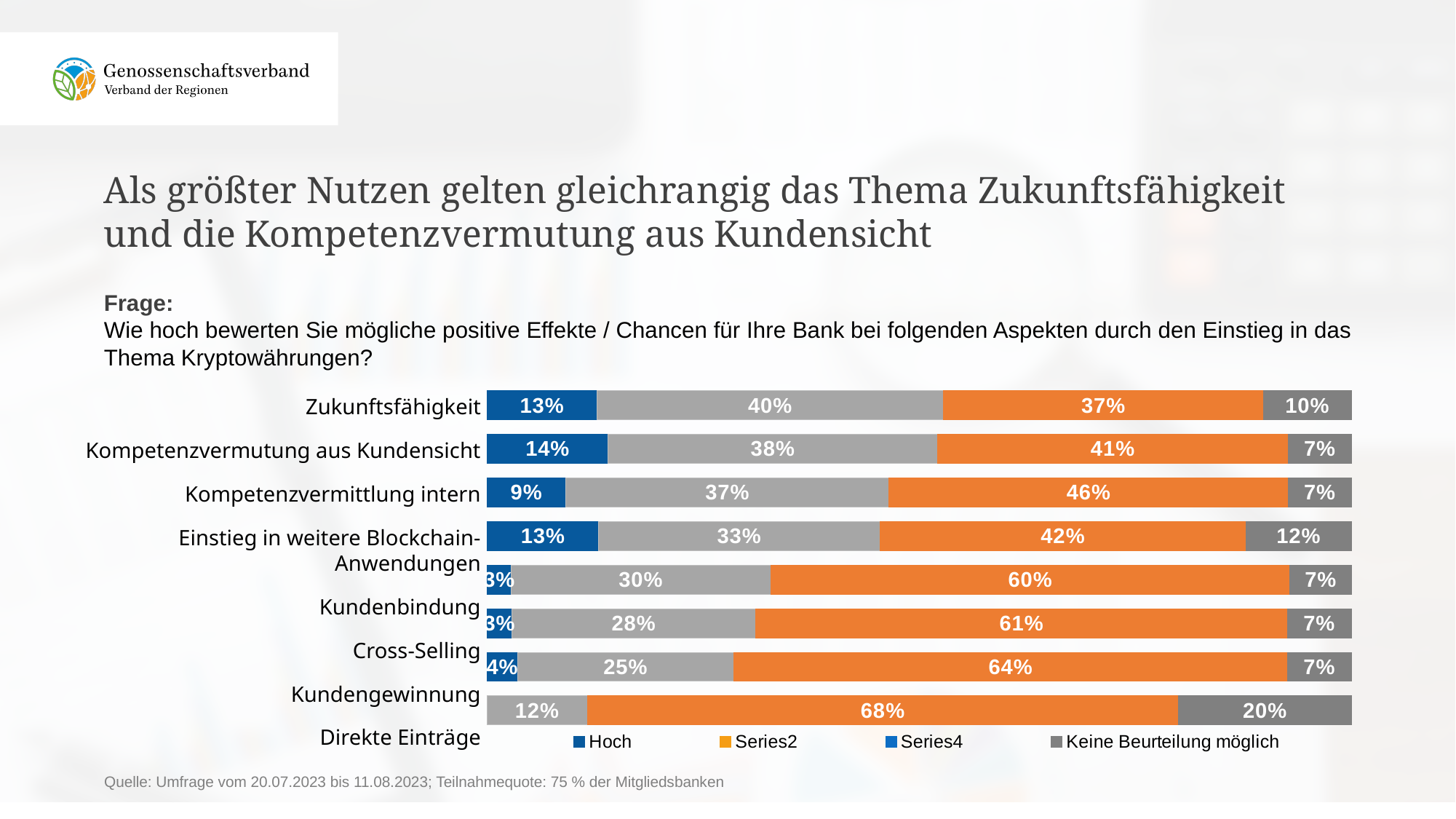
How many categories are shown in the chart? 8 Which category has the largest orange segment? Direkte Einträge What is the difference between the "Hoch" values for Zukunftsfähigkeit and Kompetenzvermittlung intern? 4 percentage points Which has the larger orange segment, Kundenbindung or Cross-Selling? Cross-Selling What is the "Keine Beurteilung möglich" value for Direkte Einträge? 20% What is the "Hoch" value for Zukunftsfähigkeit? 13% Which category has the largest "Keine Beurteilung möglich" value? Direkte Einträge What is the value of the orange segment for Kundengewinnung? 64% What is the total of the stacked bar for Zukunftsfähigkeit? 100% Which category has the highest "Hoch" value? Kompetenzvermutung aus Kundensicht How many series does the legend list? 4 What kind of chart is shown on the slide? Stacked bar chart